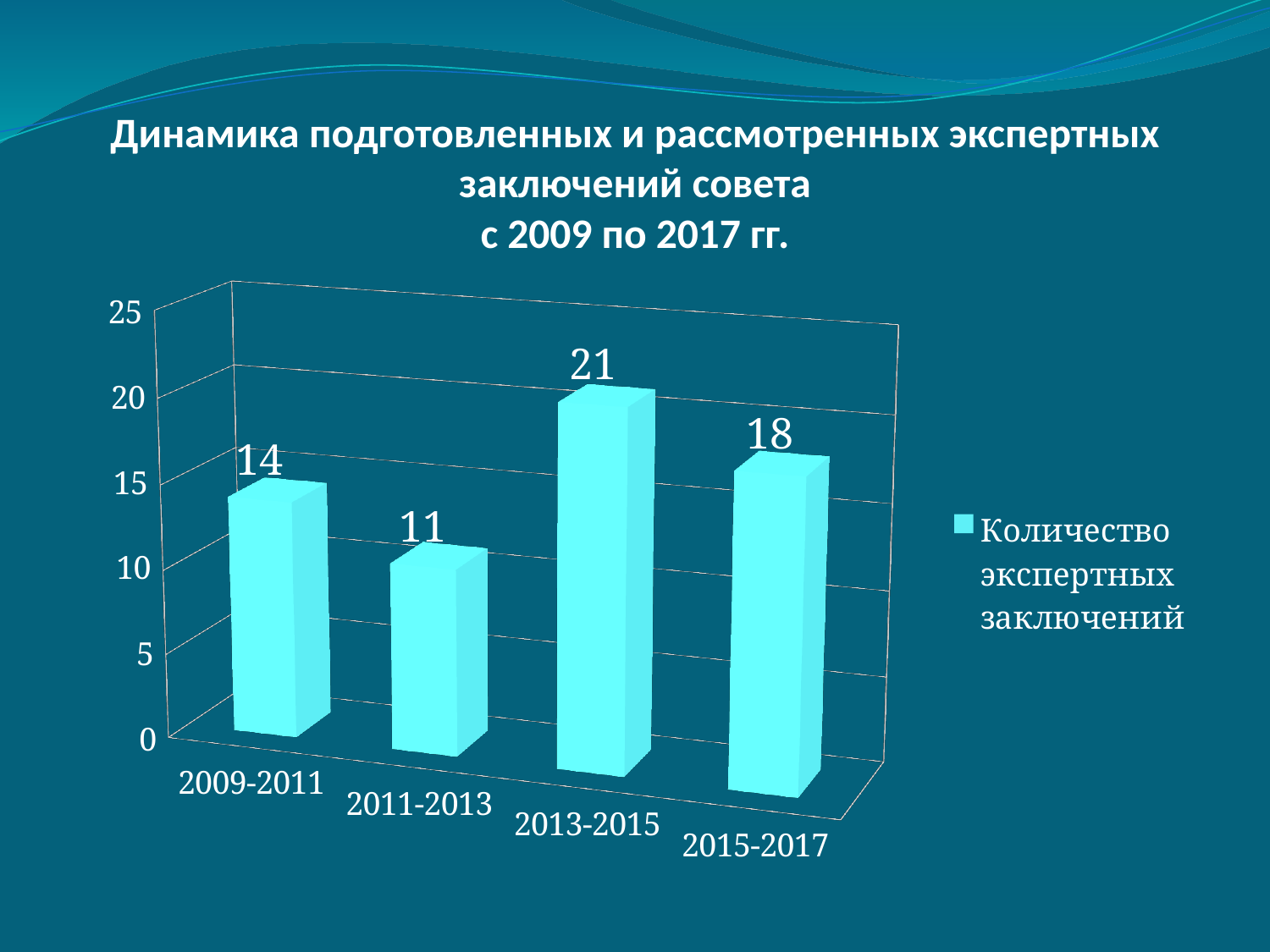
Which is larger, the value for 2009-2011 or the value for 2015-2017? 2015-2017 What is the difference between the values for 2013-2015 and 2011-2013? 10 What kind of chart is shown on the slide? bar chart What is the number of expert conclusions for 2015-2017? 18 What is the number of expert conclusions for 2013-2015? 21 How many series does the legend list? 1 Is the value for 2013-2015 greater or less than 20? greater What is the number of expert conclusions for 2011-2013? 11 What is the number of expert conclusions for 2009-2011? 14 Which period has the lowest number of expert conclusions? 2011-2013 How many periods are shown on the x axis? 4 Which period has the highest number of expert conclusions? 2013-2015